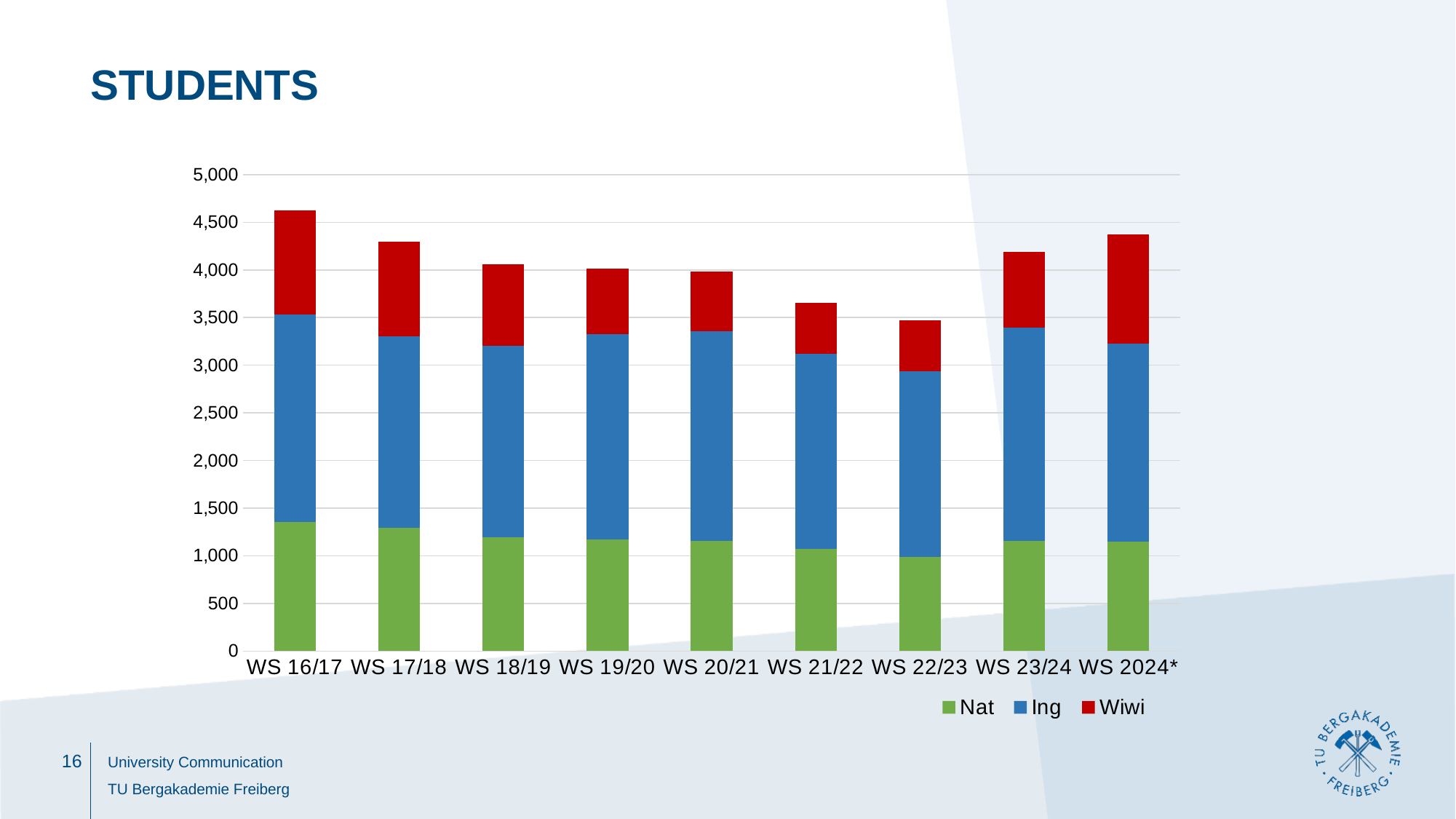
How many series does the legend list? 3 Which semester has the highest total number of students? WS 16/17 Which semester has the lowest total number of students? WS 22/23 Is the total for WS 22/23 greater or less than 4,000? less Is the total for WS 2024* greater or less than 4,000? greater Is the Nat value for WS 16/17 greater or less than 1,000? greater Which has the larger total, WS 16/17 or WS 2024*? WS 16/17 Which series is shown in red in the legend? Wiwi How many semesters (categories) are shown on the x axis? 9 Do the total student numbers rise or fall from WS 16/17 to WS 22/23? fall What kind of chart is shown on the slide? Stacked bar chart